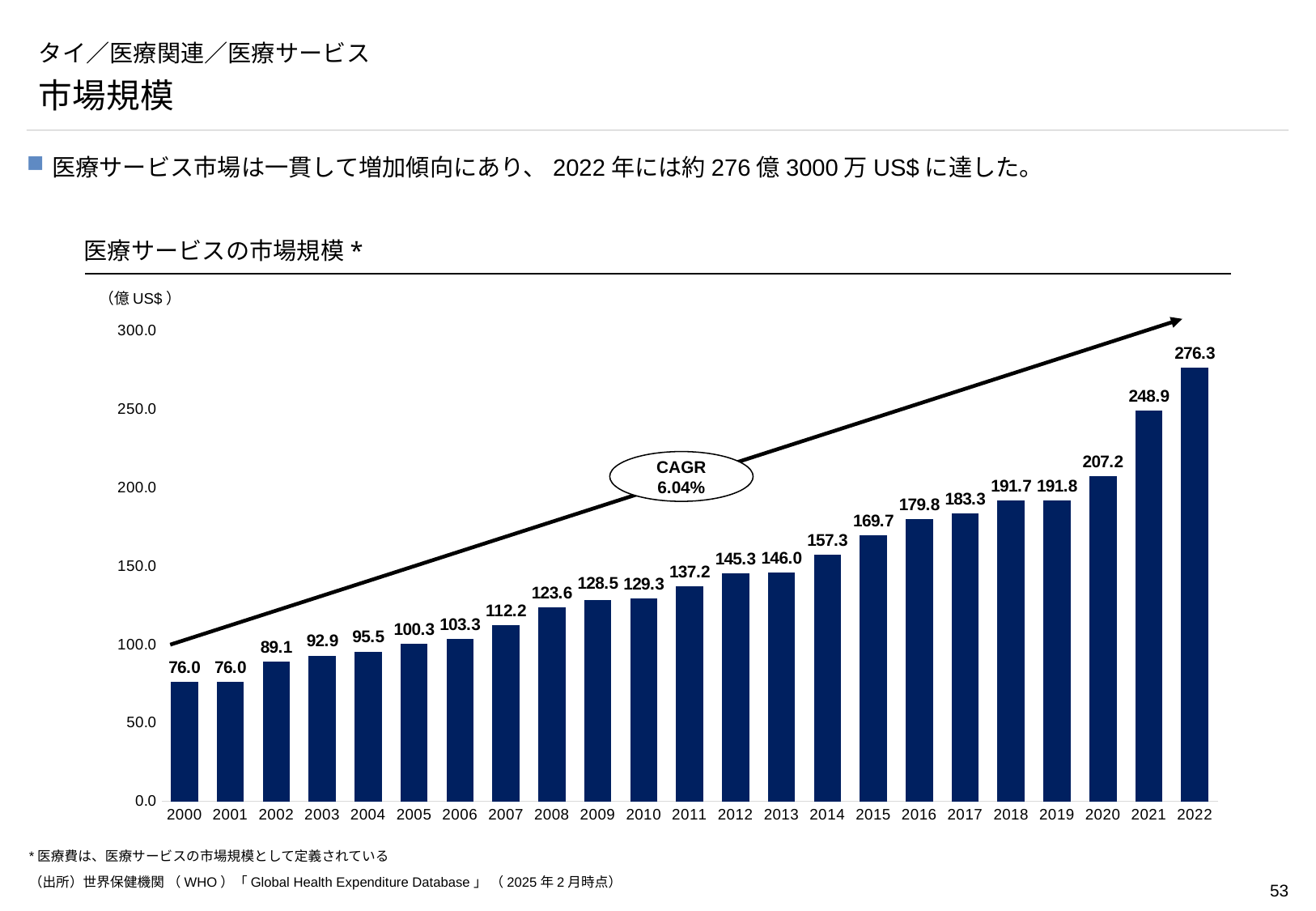
Is the value for 2020 greater or less than 200.0? greater What is the value for 2010? 129.3 Do the values rise or fall from 2000 to 2022? Rise What kind of chart is this? Bar chart How many years are shown on the x axis? 23 Which is larger, the value for 2015 or the value for 2013? 2015 What is the difference between the values for 2022 and 2021? 27.4 What CAGR is shown in the oval on the chart? 6.04% What is the lowest value shown in the chart? 76.0 What is the value for 2022? 276.3 Which year has the highest value? 2022 What is the value for 2005? 100.3